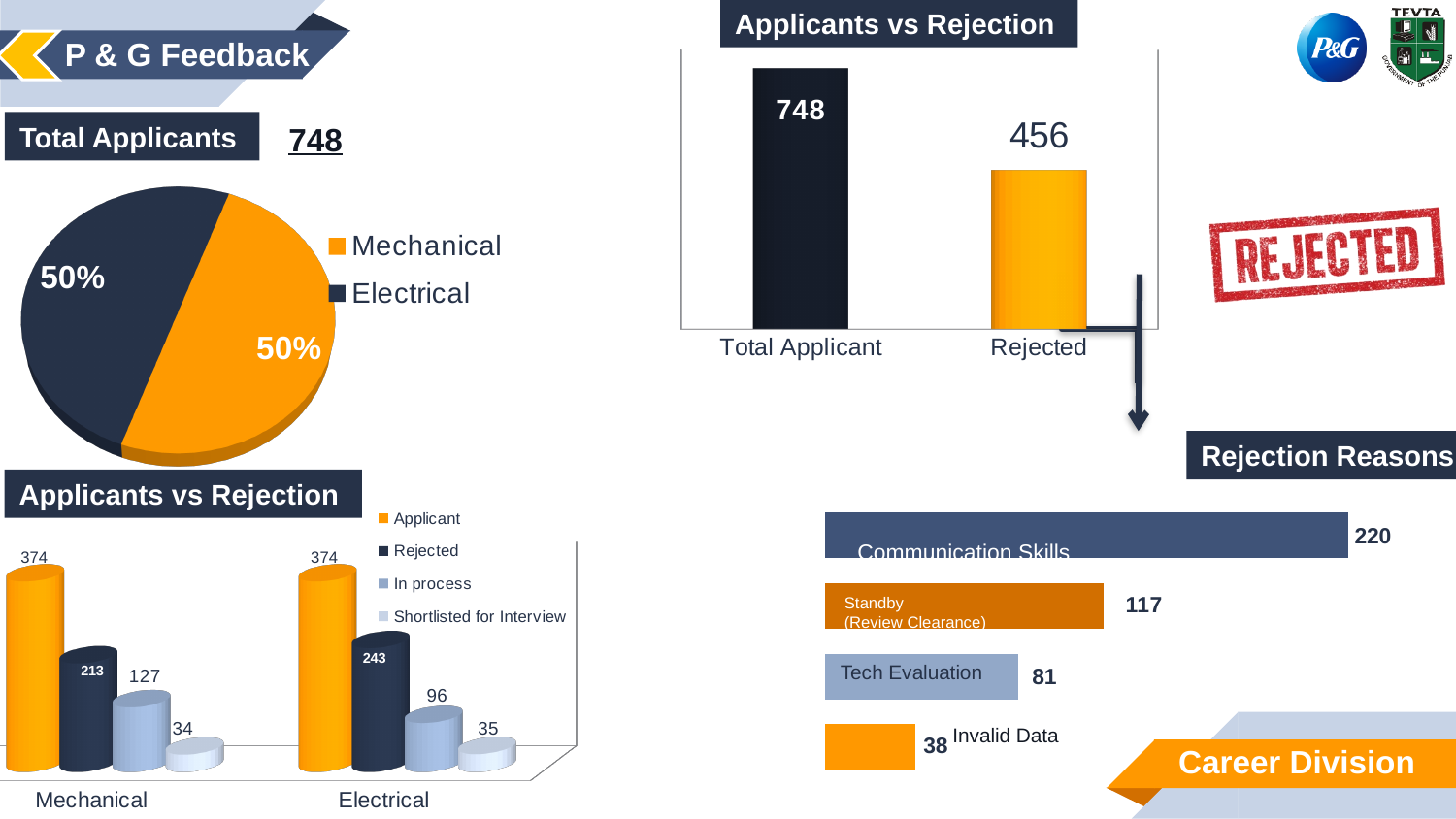
In the bottom-left 'Applicants vs Rejection' chart, which is larger: Rejected for Mechanical or Rejected for Electrical? Electrical In the bottom-left 'Applicants vs Rejection' chart, what is the In process value for Mechanical? 127 In the top-centre 'Applicants vs Rejection' chart, what is the difference between Total Applicant and Rejected? 292 In the pie chart on the left, what share is Mechanical? 50% In the 'Rejection Reasons' chart, what is the value for Tech Evaluation? 81 What kind of chart is the top-centre 'Applicants vs Rejection' chart? bar chart In the 'Rejection Reasons' chart, which reason has the highest value? Communication Skills In the top-centre 'Applicants vs Rejection' chart, what is the value for Rejected? 456 How many series does the legend of the pie chart on the left list? 2 In the 'Rejection Reasons' chart, which reason has the lowest value? Invalid Data In the bottom-left 'Applicants vs Rejection' chart, what is the Rejected value for Electrical? 243 How many series does the legend of the bottom-left 'Applicants vs Rejection' chart list? 4